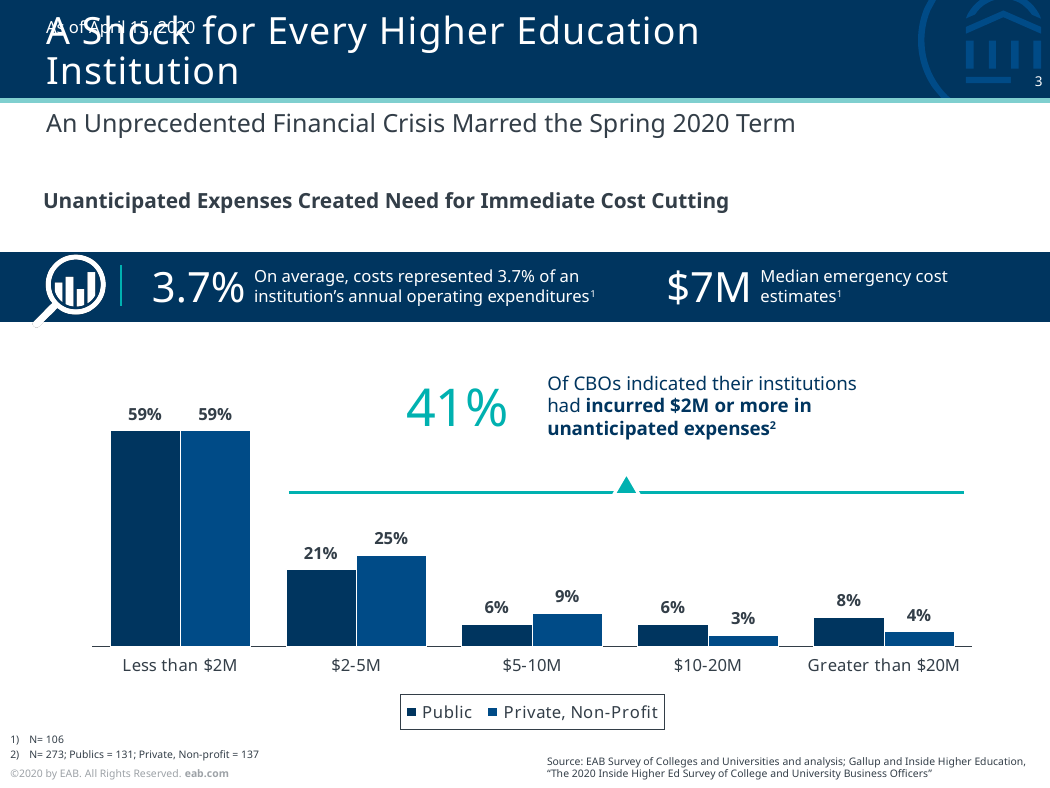
Do the Public values rise or fall from the Less than $2M category to the $5-10M category? fall What is the difference between the Private, Non-Profit and Public values in the $2-5M category? 4% How many series does the chart legend list? 2 What is the value for Private, Non-Profit in the $5-10M category? 9% Which category has the lowest value for Private, Non-Profit? $10-20M Which series is shown in the darker blue colour in the chart legend? Public What kind of chart is shown on the slide? bar chart How many expense categories are shown on the x axis of the chart? 5 What is the value for Public in the $2-5M category? 21% In the $10-20M category, which series has the larger value, Public or Private, Non-Profit? Public Which category has the highest value for Private, Non-Profit? Less than $2M What is the value for Public in the Greater than $20M category? 8%